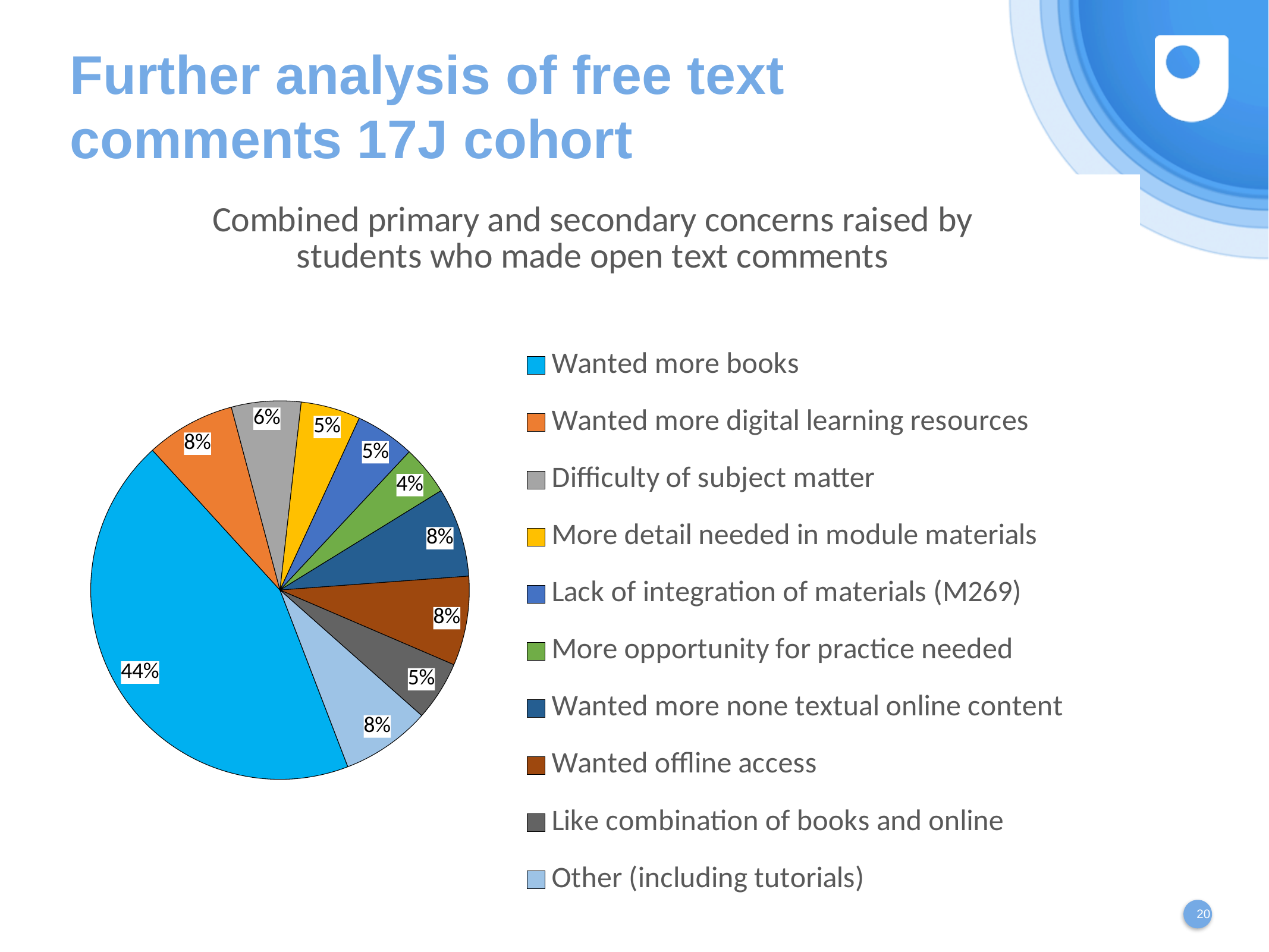
Which category has the largest share of the pie? Wanted more books What kind of chart is shown on the slide? pie chart What share of the pie is 'Like combination of books and online'? 5% How many categories does the legend list? 10 What share of the pie is 'Wanted more books'? 44% What is the title of the chart? Combined primary and secondary concerns raised by students who made open text comments What share of the pie is 'Wanted offline access'? 8% What share of the pie is 'More opportunity for practice needed'? 4% Which is larger: the share for 'Difficulty of subject matter' or the share for 'More detail needed in module materials'? Difficulty of subject matter What is the difference between the share for 'Wanted more books' and the share for 'Wanted more digital learning resources'? 36% Which category has the smallest share of the pie? More opportunity for practice needed What share of the pie is 'Difficulty of subject matter'? 6%